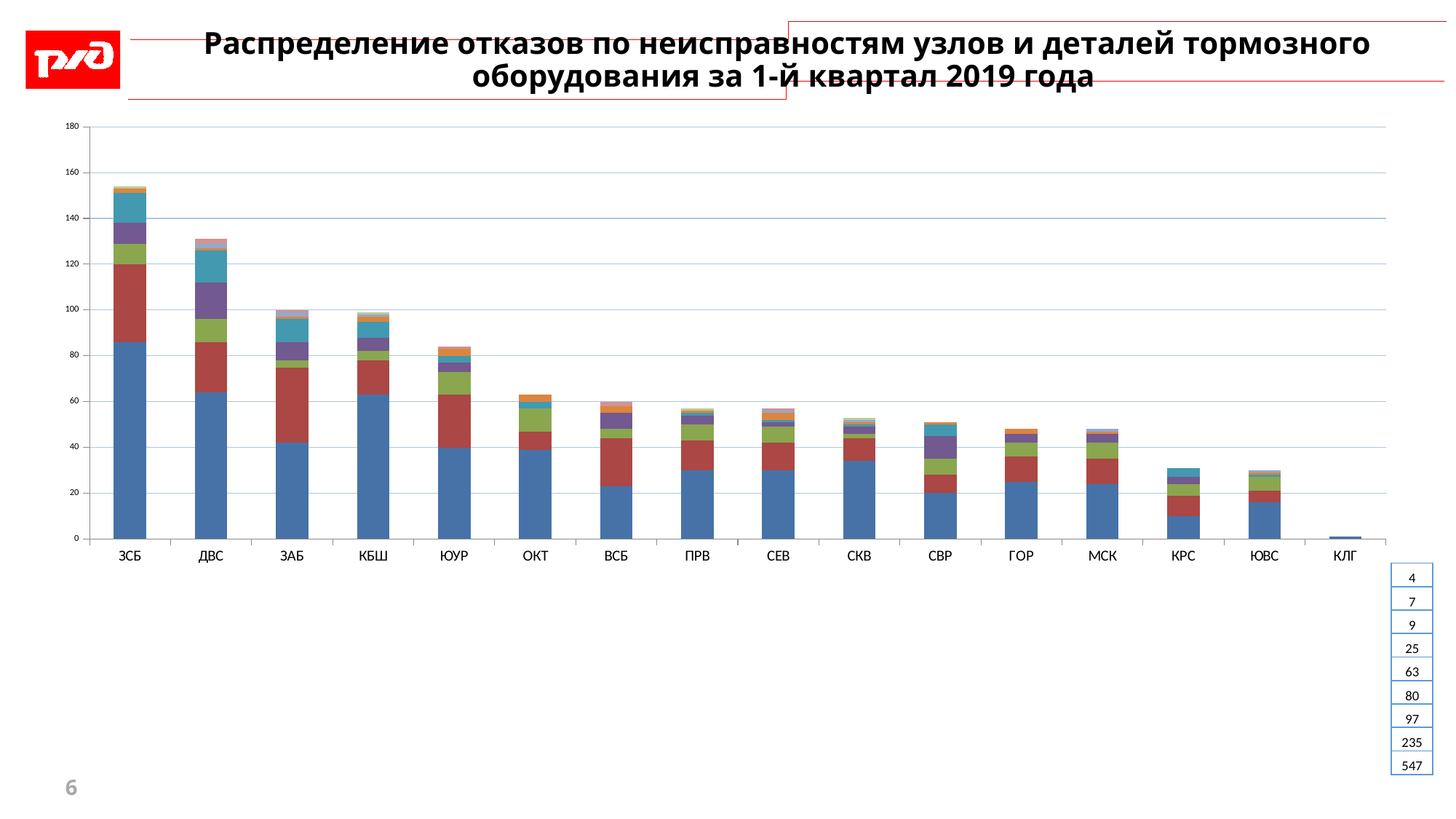
Do the total bar heights generally rise or fall from left to right along the x axis? fall Which category has the tallest stacked bar? ЗСБ What kind of chart is shown on the slide? stacked bar chart Is the total value for ДВС greater or less than 120? greater Which category has the shortest stacked bar? КЛГ Which has the larger total bar, ЗСБ or ДВС? ЗСБ Is the total value for КЛГ greater or less than 20? less Is the total value for ЗСБ greater or less than 140? greater How many categories are shown along the x axis of the chart? 16 What period does the chart title say the data covers? 1-й квартал 2019 года